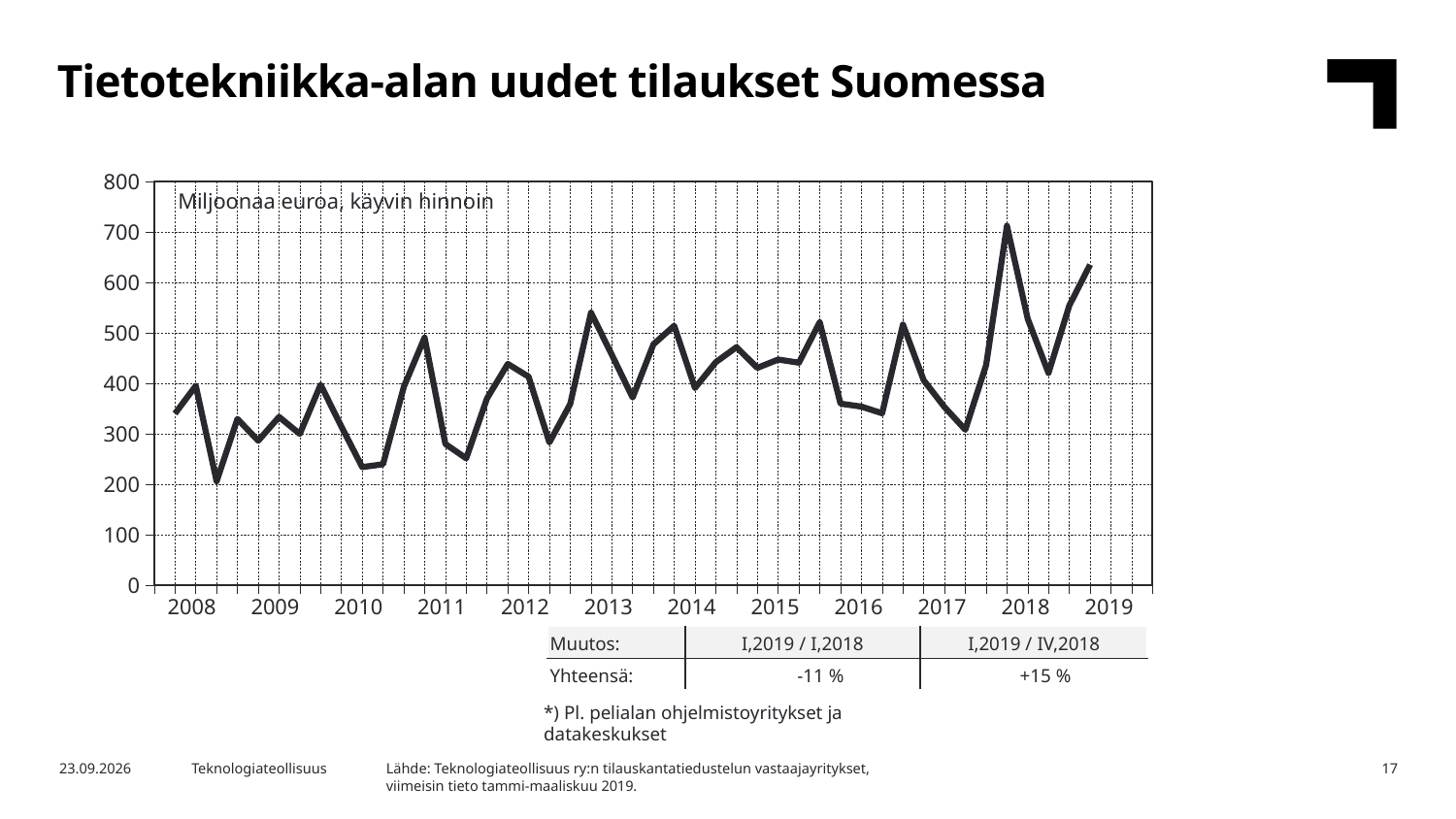
According to the table below the chart, what is the change I,2019 / I,2018? -11 % Is the value at the start of 2008 greater or less than 400? less According to the table below the chart, what is the change I,2019 / IV,2018? +15 % What unit is stated inside the chart area? Miljoonaa euroa, käyvin hinnoin How many year labels are shown on the x axis? 12 What kind of chart is shown on the slide? line chart Is the peak value of the line in 2018 greater or less than 600? greater Which year contains the highest point of the line? 2018 What is the highest value shown on the y axis? 800 Is the lowest value of the line in 2008 greater or less than 300? less What is the title of the chart on the slide? Tietotekniikka-alan uudet tilaukset Suomessa